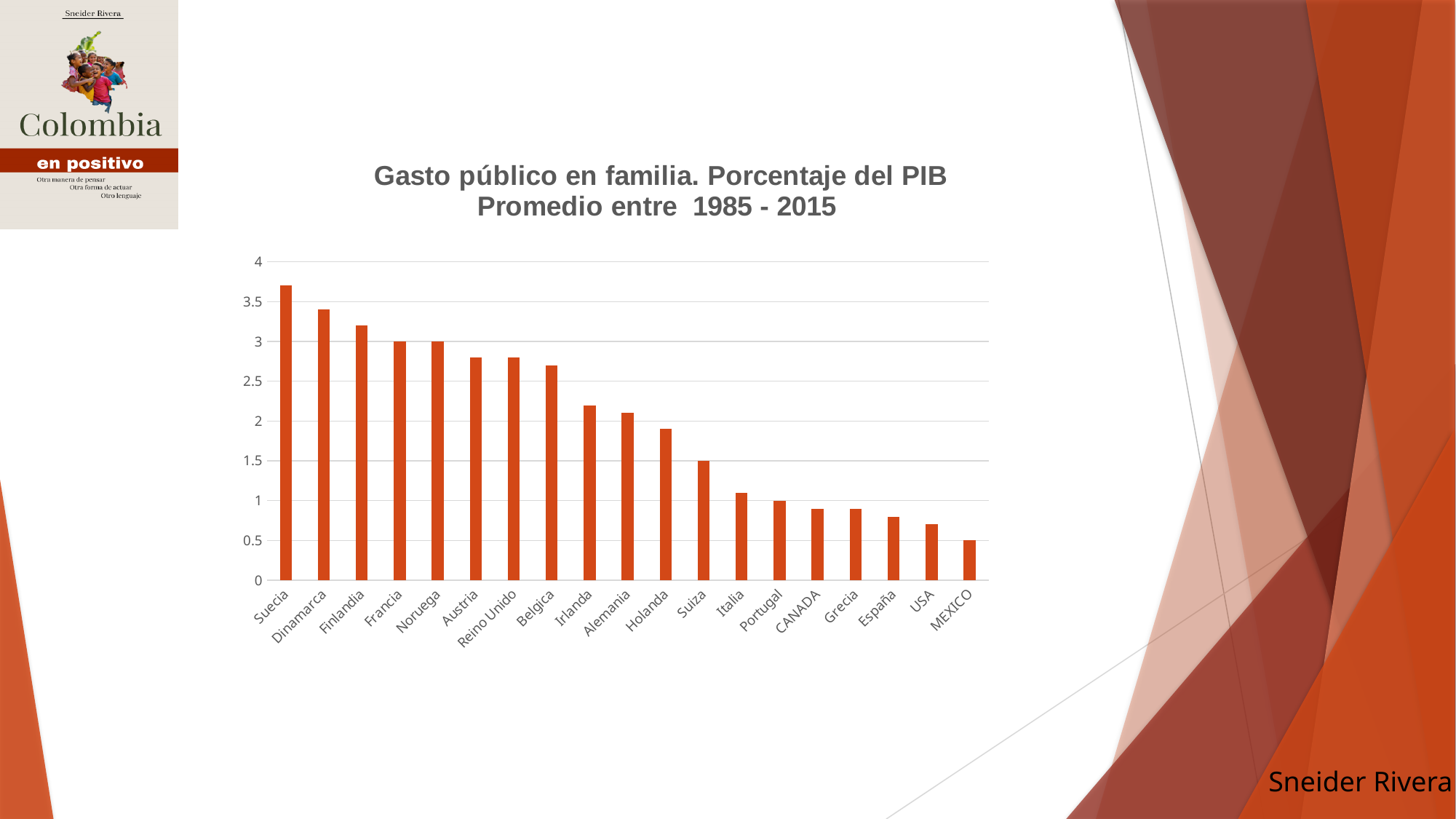
How many countries are shown on the x axis of the chart? 19 What is the value for Suiza? 1.5 Which country has the highest value in the chart? Suecia Is the value for Holanda greater or less than 2? less Do the values rise or fall moving from left to right along the x axis? fall Which country has the lowest value in the chart? MEXICO Which is larger, the value for Dinamarca or the value for Irlanda? Dinamarca What type of chart is shown on the slide? bar chart What is the value for MEXICO? 0.5 What is the value for Francia? 3 What is the title of the chart? Gasto público en familia. Porcentaje del PIB Promedio entre 1985 - 2015 Is the value for Suecia greater or less than 3.5? greater